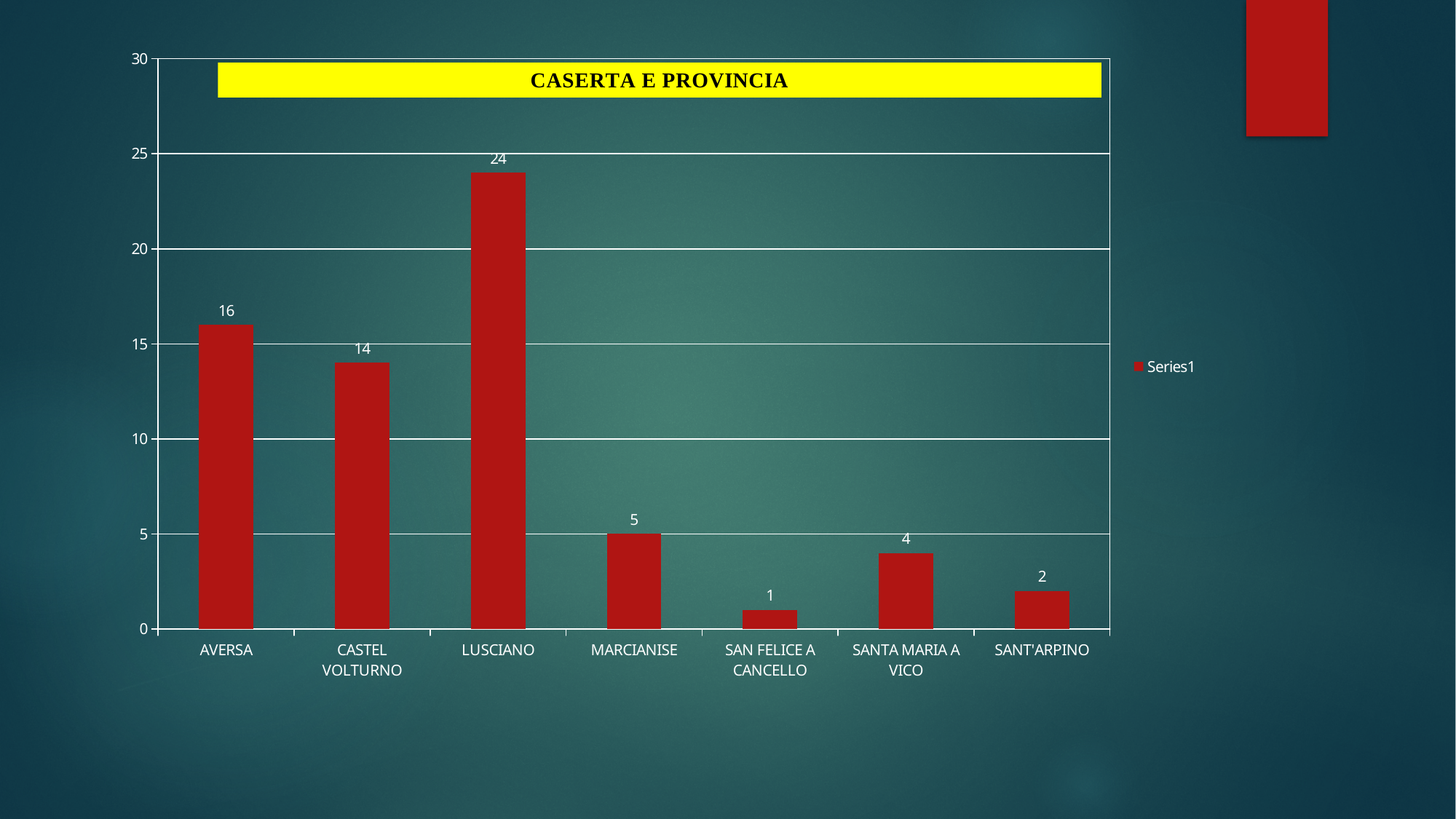
What kind of chart is shown on the slide? bar chart What is the value for CASTEL VOLTURNO? 14 What is the value for LUSCIANO? 24 How many categories are shown on the x axis? 7 What is the title of the chart? CASERTA E PROVINCIA Which category has the highest value? LUSCIANO How many series does the legend list? 1 Is the value for AVERSA greater or less than 15? greater What is the value for SAN FELICE A CANCELLO? 1 Which category has the lowest value? SAN FELICE A CANCELLO Which is larger, the value for MARCIANISE or the value for SANTA MARIA A VICO? MARCIANISE What is the difference between the values for LUSCIANO and AVERSA? 8